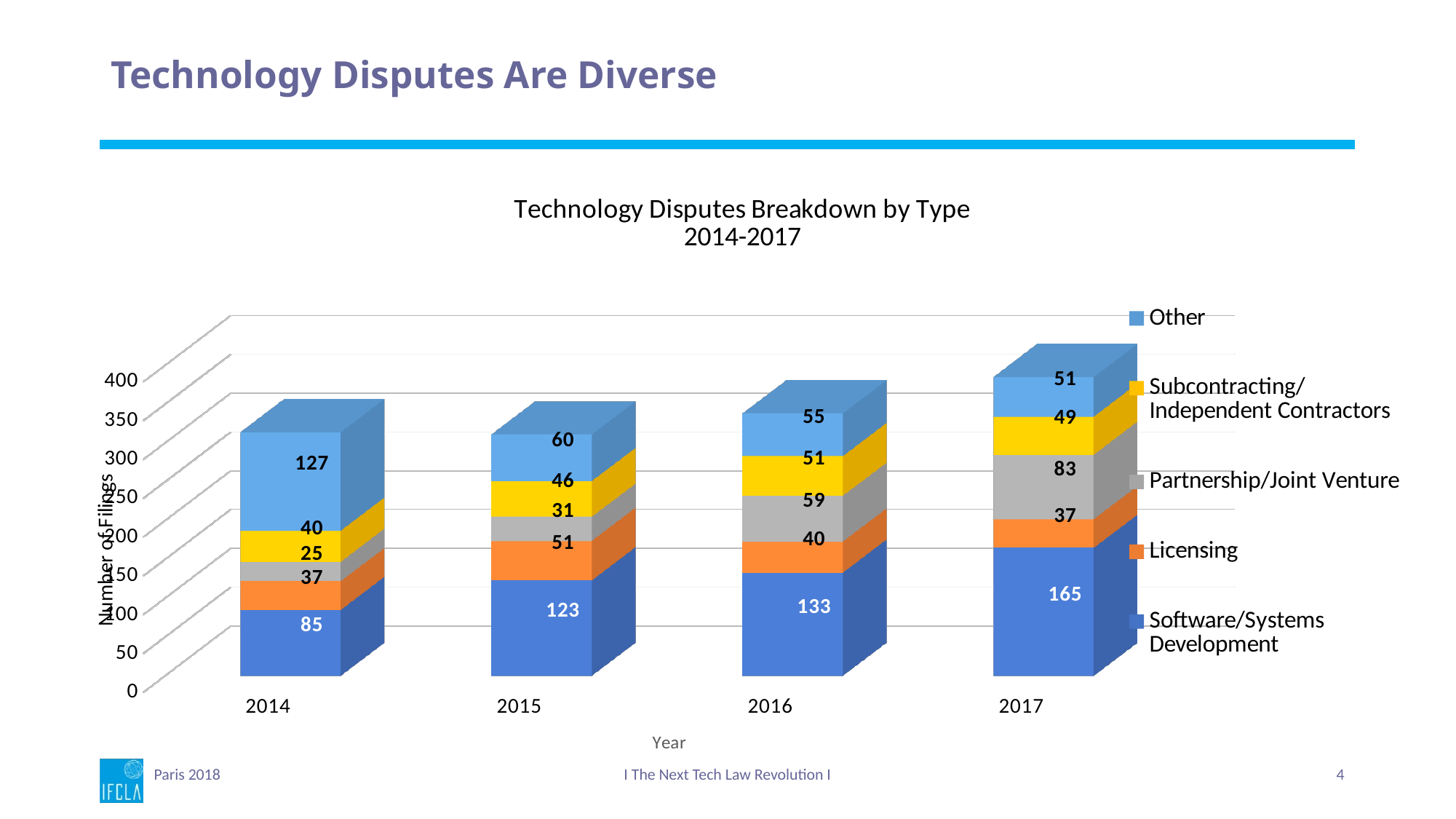
What is the value for Software/Systems Development in 2017? 165 What is the value for Other in 2014? 127 What is the value for Partnership/Joint Venture in 2016? 59 Which year has the highest value for Software/Systems Development? 2017 What is the total of the stacked bar for 2017? 385 What kind of chart is shown on the slide? Stacked bar chart Which year has the lowest value for Partnership/Joint Venture? 2014 What is the difference between the Software/Systems Development values for 2017 and 2014? 80 How many years are shown on the x axis? 4 What is the value for Licensing in 2015? 51 Which is larger, the Other value for 2015 or for 2016? 2015 How many series does the legend list? 5